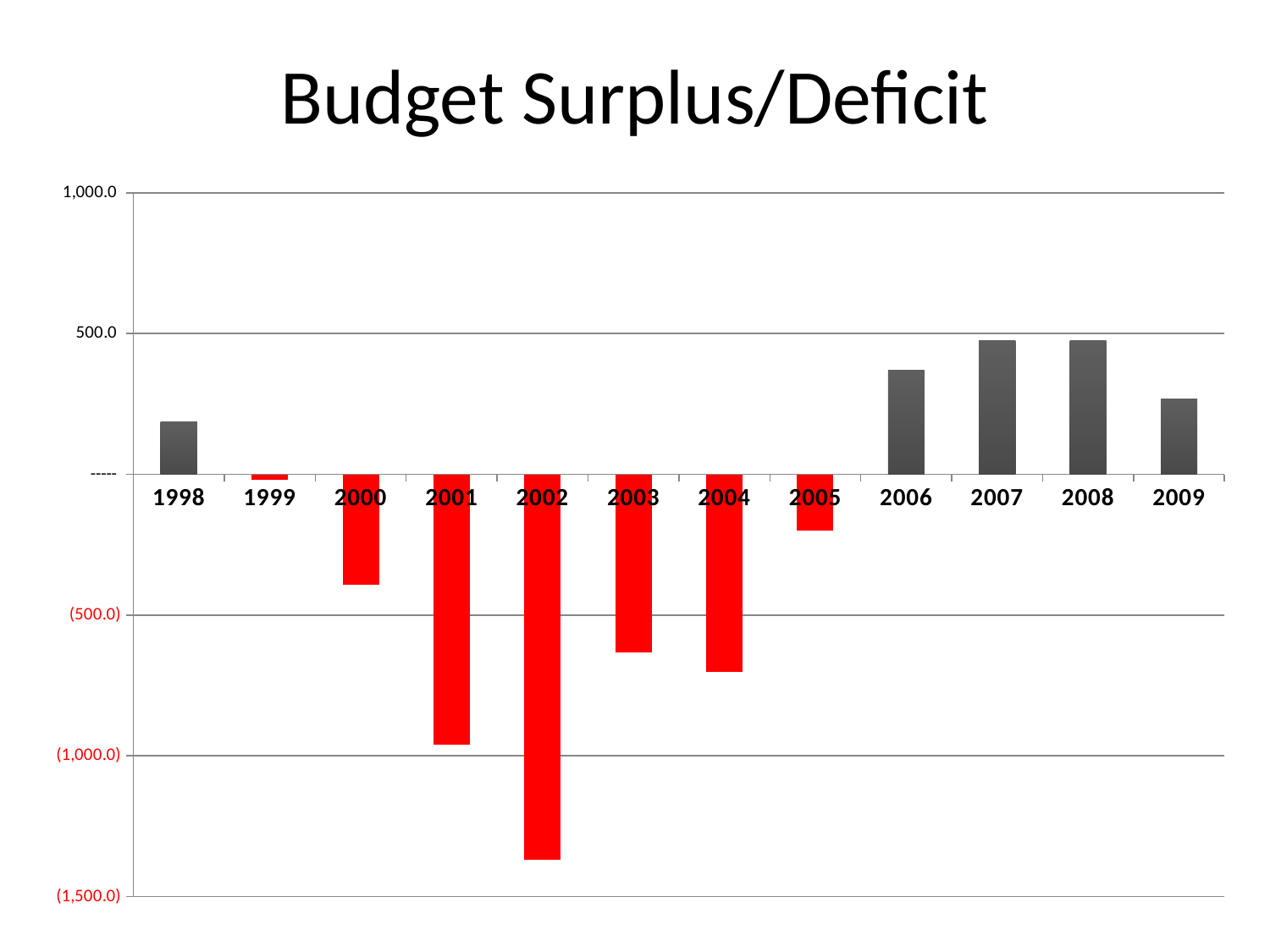
How many years are plotted on the x axis? 12 What kind of chart is shown on the slide? bar chart Which is larger, the value for 1998 or the value for 2007? 2007 Is the value for 2000 greater or less than (500.0)? greater What colour are the bars for the years with a deficit (negative values)? red What is the title of the chart? Budget Surplus/Deficit Is the value for 2002 greater or less than (1,000.0)? less Which is larger, the value for 2003 or the value for 2004? 2003 Which year has the lowest value (largest deficit)? 2002 Is the value for 2001 greater or less than (500.0)? less Which is larger, the value for 2006 or the value for 2009? 2006